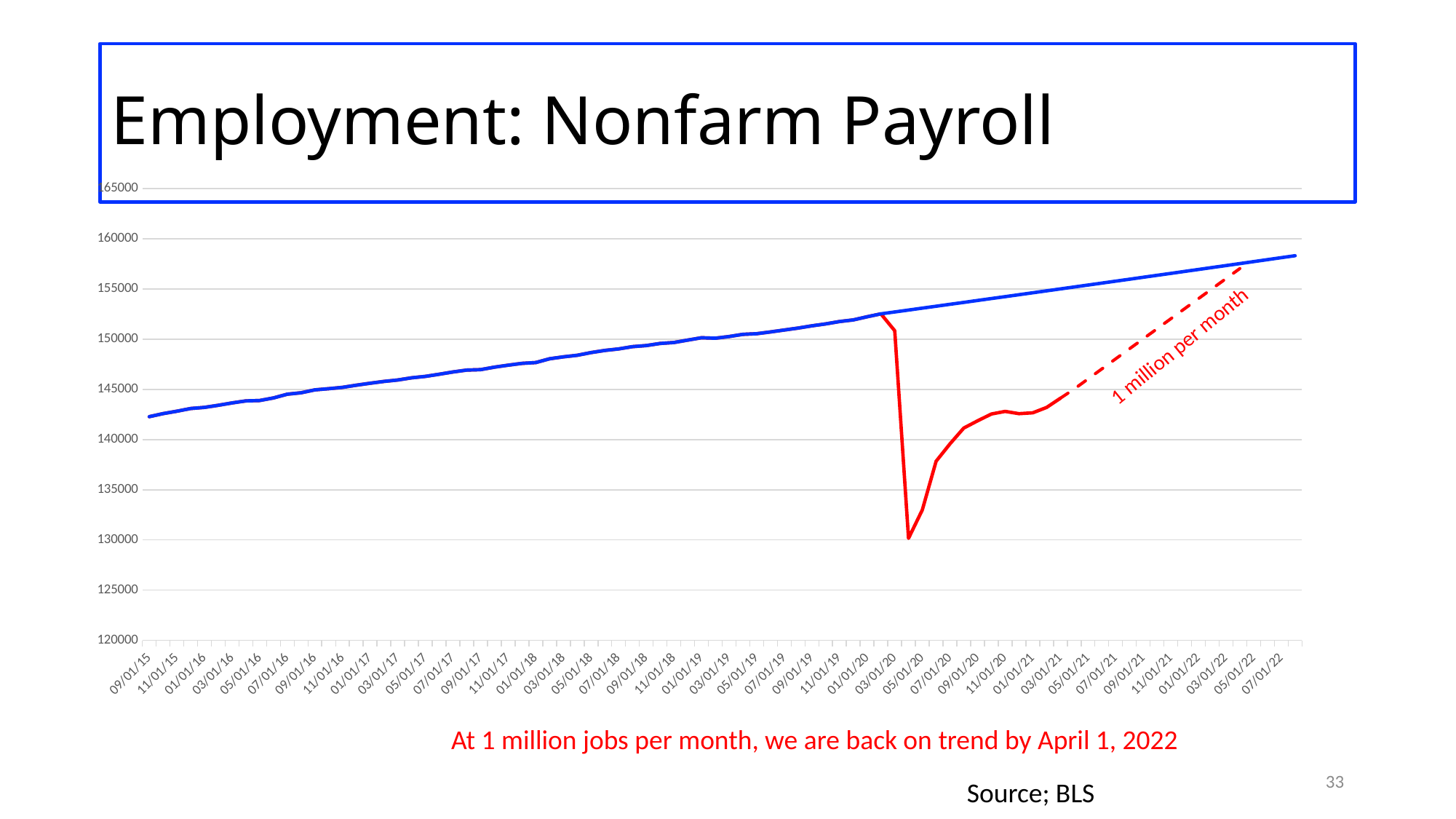
What is the title of the chart on the slide? Employment: Nonfarm Payroll On the red line, which is higher: the value at 04/01/20 or the value at 09/01/20? 09/01/20 Is the value of the blue line at 01/01/20 greater or less than 150000? greater Is the lowest point of the red line, around 04/01/20, greater or less than 135000? less Is the value of the blue line at 07/01/22 greater or less than 155000? greater What does the red annotation next to the dashed red line say? 1 million per month Does the blue line generally rise or fall from 09/01/15 to 07/01/22? rise What kind of chart is shown on the slide? line chart At 01/01/21, which line is higher, the blue line or the red line? the blue line